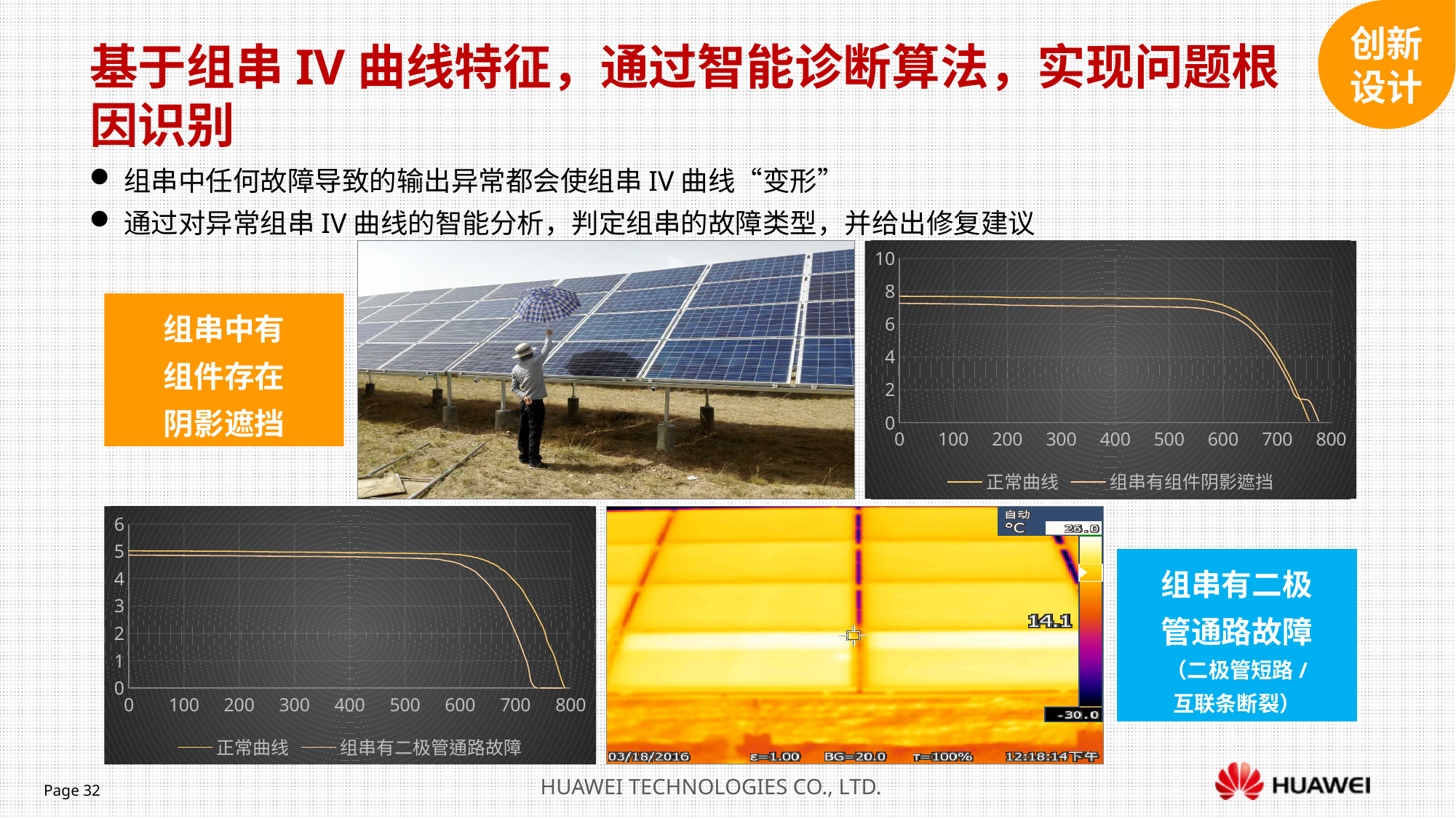
What kind of chart is the bottom-left chart on the slide? line chart In the bottom-left chart, is the value of the 组串有二极管通路故障 series at x = 300 greater or less than 2? greater In the top-right chart, what are the two legend entries? 正常曲线, 组串有组件阴影遮挡 In the bottom-left chart, what are the two legend entries? 正常曲线, 组串有二极管通路故障 In the bottom-left chart, do the curves rise or fall as the x axis increases toward 800? fall How many series does the legend of the bottom-left chart list? 2 In the top-right chart, is the value of the 正常曲线 series at x = 100 greater or less than 6? greater In the top-right chart, is the value of the 组串有组件阴影遮挡 series at x = 700 greater or less than 8? less In the top-right chart, do the curves rise or fall as the x axis increases toward 800? fall What kind of chart is the top-right chart on the slide? line chart How many series does the legend of the top-right chart list? 2